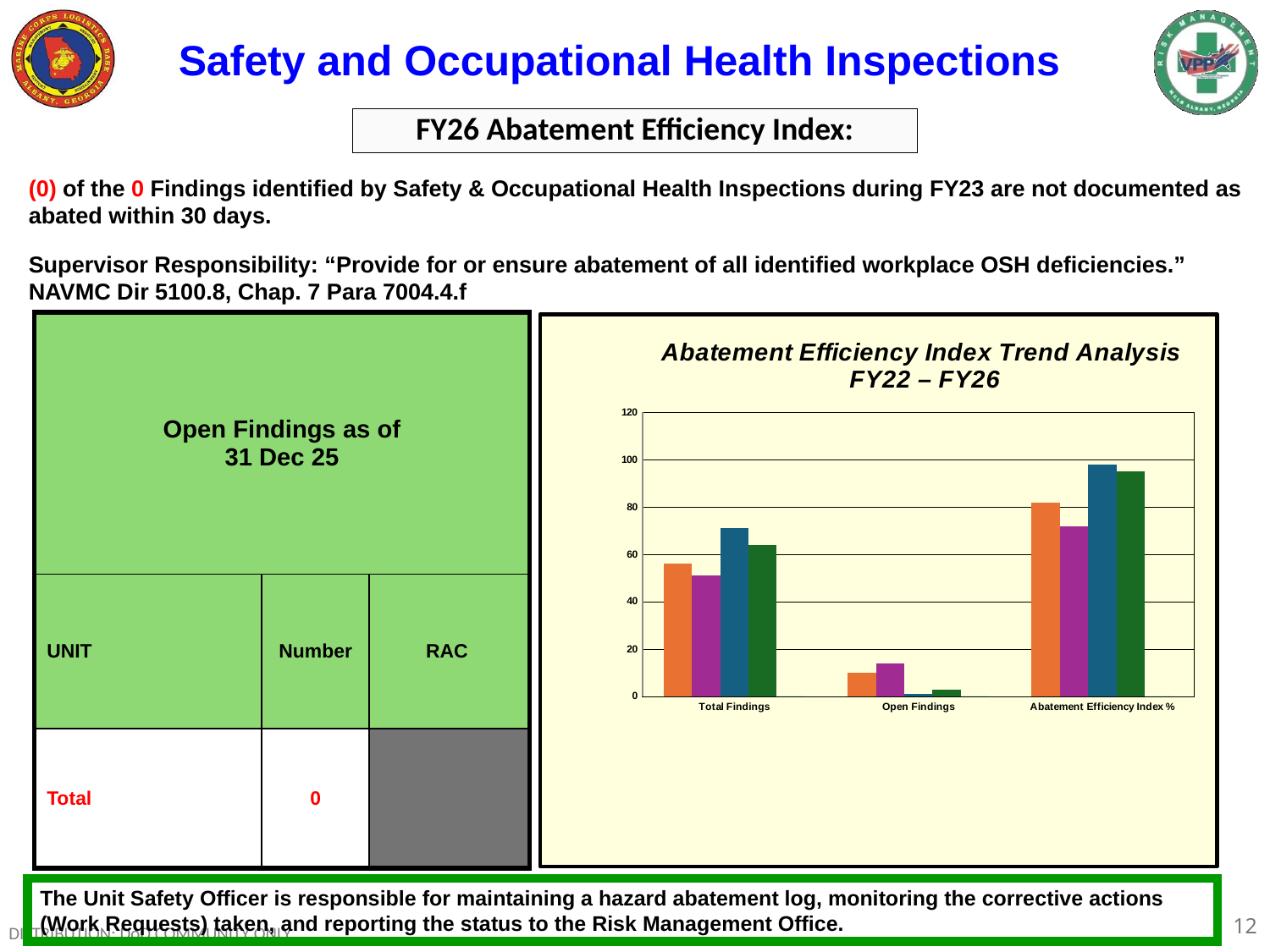
Is the value of the blue bar for Total Findings greater or less than 60? greater What is the highest value shown on the y axis of the chart? 120 For Open Findings, which is larger: the purple bar or the blue bar? The purple bar What kind of chart is shown on the slide? Bar chart Which category on the x axis has the tallest bars? Abatement Efficiency Index % Is the value of the orange bar for Open Findings greater or less than 20? less What is the title of the chart? Abatement Efficiency Index Trend Analysis FY22 – FY26 Is the value of the blue bar for Abatement Efficiency Index % greater or less than 80? greater Which category on the x axis has the shortest bars? Open Findings For Total Findings, which is larger: the blue bar or the purple bar? The blue bar How many categories are shown on the x axis of the chart? 3 How many bars are plotted for each category on the x axis? 4